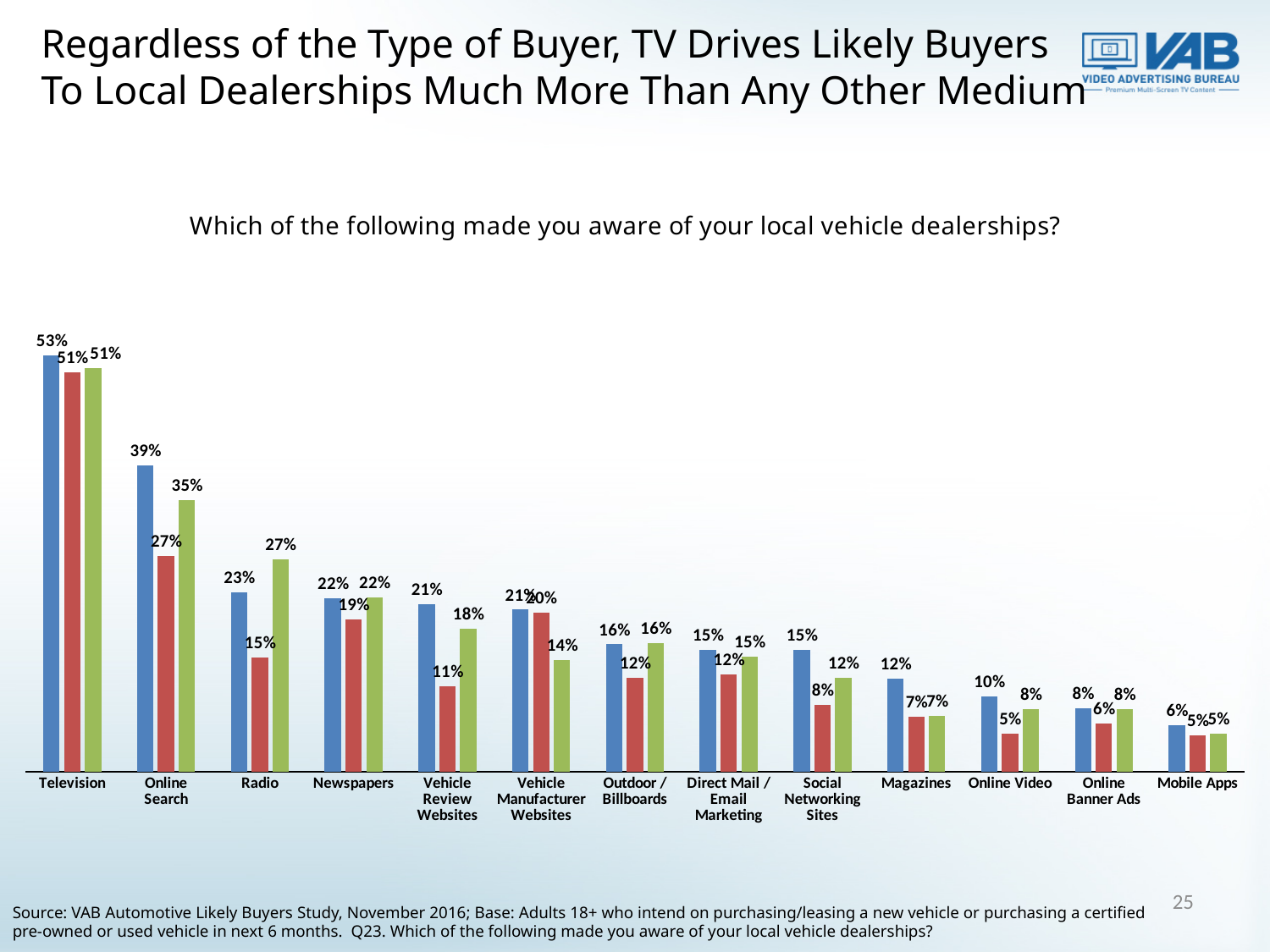
How many categories are shown on the x axis? 13 What is the value of the green bar for Radio? 27% What is the value of the blue bar for Television? 53% How many bars are shown for each category? 3 What is the difference between the blue bar and the red bar for Online Search? 12% Which category has the lowest blue bar? Mobile Apps What is the value of the red bar for Vehicle Review Websites? 11% What question is the chart based on, as shown above the chart? Which of the following made you aware of your local vehicle dealerships? Which category has the highest blue bar? Television Which is larger for Radio: the blue bar or the green bar? the green bar What kind of chart is shown on the slide? bar chart What is the value of the red bar for Online Search? 27%